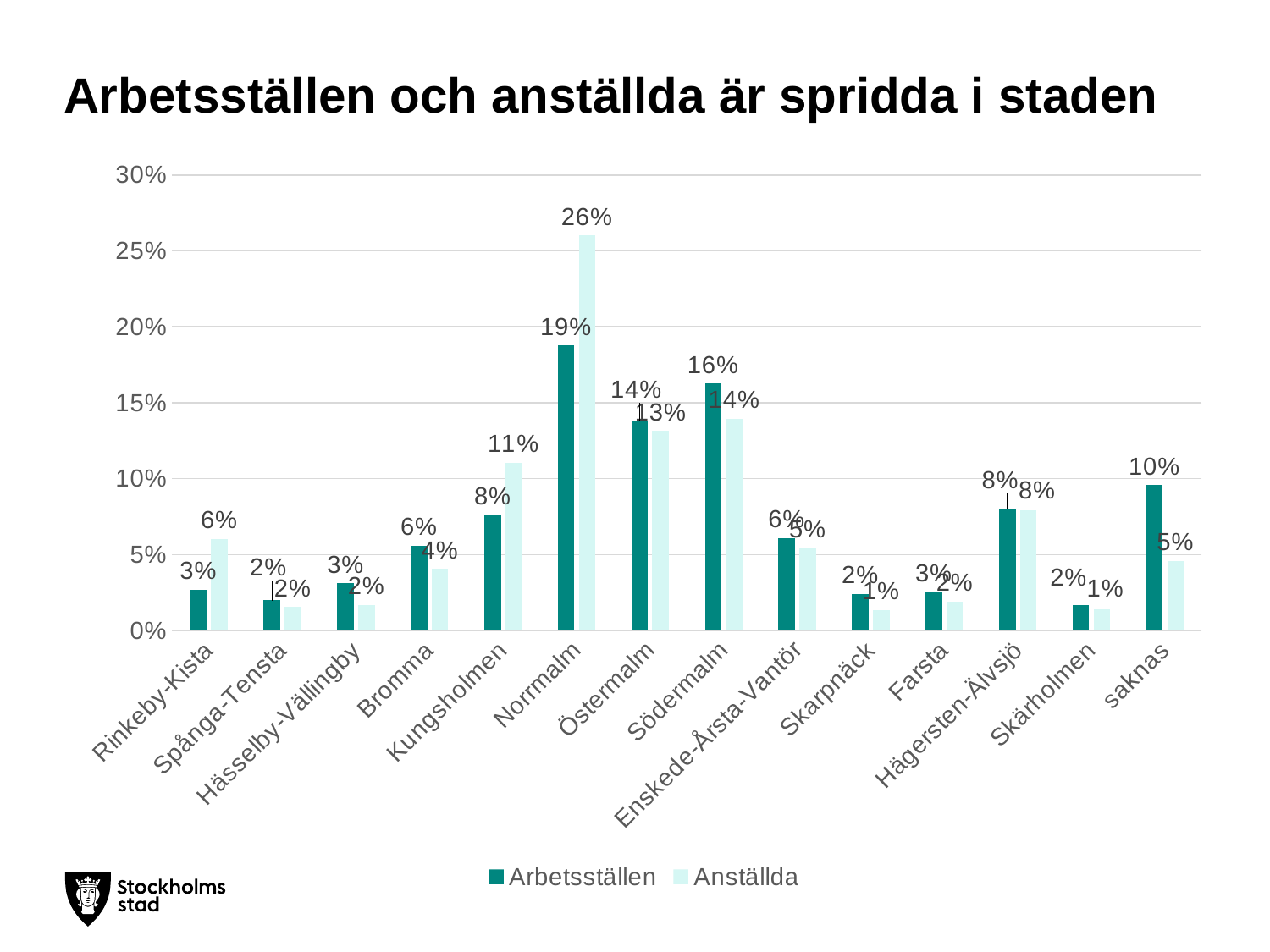
What is the title of the slide? Arbetsställen och anställda är spridda i staden What is the Anställda value for Kungsholmen? 11% What kind of chart is shown on the slide? Bar chart What is the Anställda value for Norrmalm? 26% What is the Arbetsställen value for saknas? 10% Which is larger for Rinkeby-Kista, the Arbetsställen value or the Anställda value? Anställda How many series does the legend list? 2 How many categories are shown on the x axis? 14 What is the Arbetsställen value for Södermalm? 16% Is the Arbetsställen value for Norrmalm greater or less than 15%? greater Which category has the highest Arbetsställen value? Norrmalm What is the difference between the Anställda and Arbetsställen values for Norrmalm? 7%